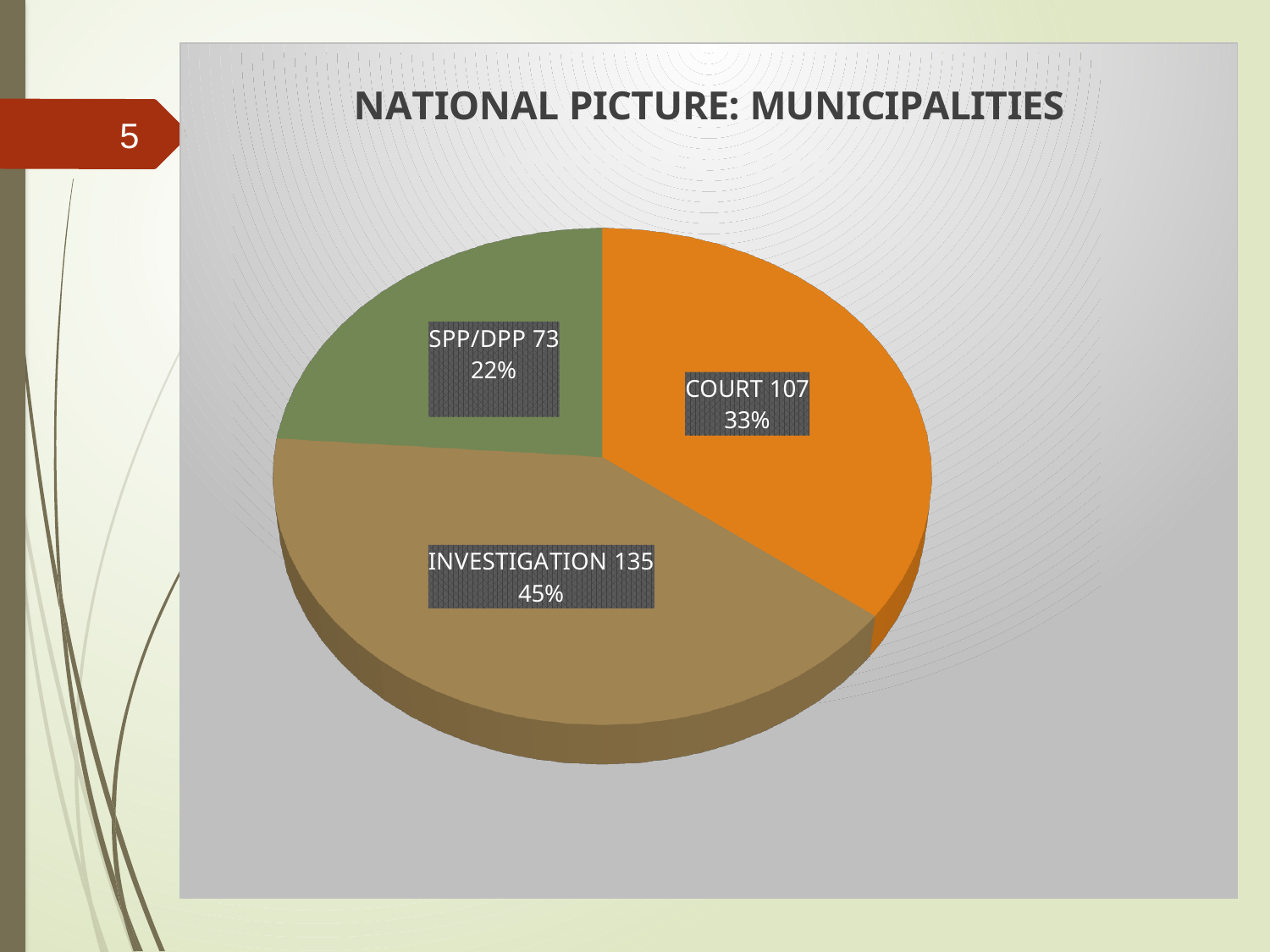
What is the difference between the COURT and SPP/DPP values? 34 What is the title of the chart? NATIONAL PICTURE: MUNICIPALITIES What kind of chart is shown? pie chart Which category has the largest slice? INVESTIGATION Which is larger, COURT or SPP/DPP? COURT What is the difference between the INVESTIGATION and COURT values? 28 What share of the pie does COURT represent? 33% How many slices does the pie chart have? 3 What is the value for COURT? 107 Which category has the smallest slice? SPP/DPP What is the value for SPP/DPP? 73 What is the value for INVESTIGATION? 135